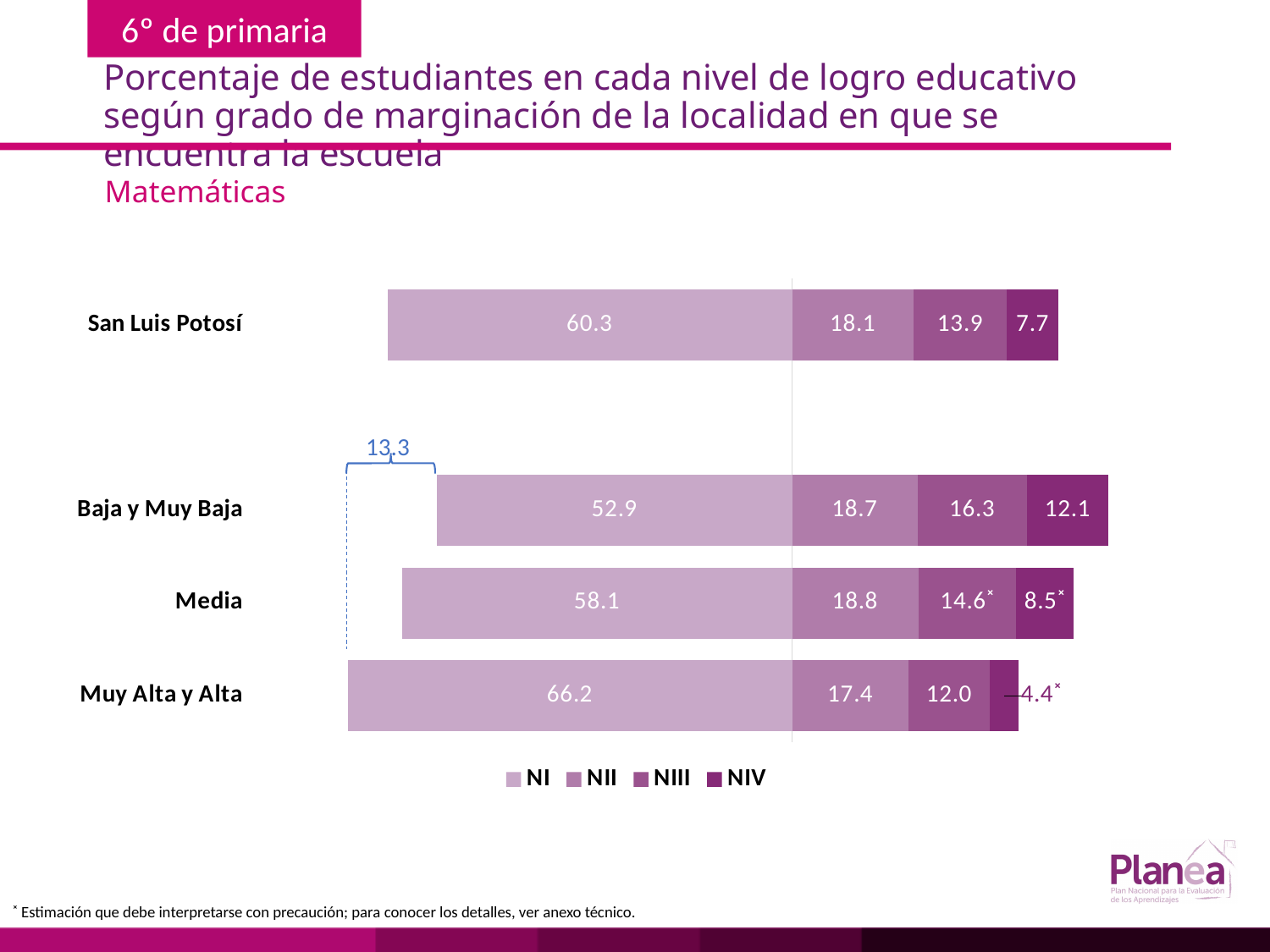
Which category has the highest NI value? Muy Alta y Alta What kind of chart is shown on the slide? Stacked bar chart Which has a larger NIII value, Baja y Muy Baja or Media? Baja y Muy Baja What is the NII value for the Media category? 18.8 What is the NIII value for Muy Alta y Alta? 12.0 What is the difference between the NI value for Muy Alta y Alta and the NI value for Baja y Muy Baja? 13.3 What percentage of students in San Luis Potosí are at level NI? 60.3 What is the NIV value for the Baja y Muy Baja category? 12.1 How many series does the legend list? 4 Which category has the lowest NIV value? Muy Alta y Alta What is the total of the San Luis Potosí bar (NI + NII + NIII + NIV)? 100.0 How many categories (bars) are shown in the chart? 4